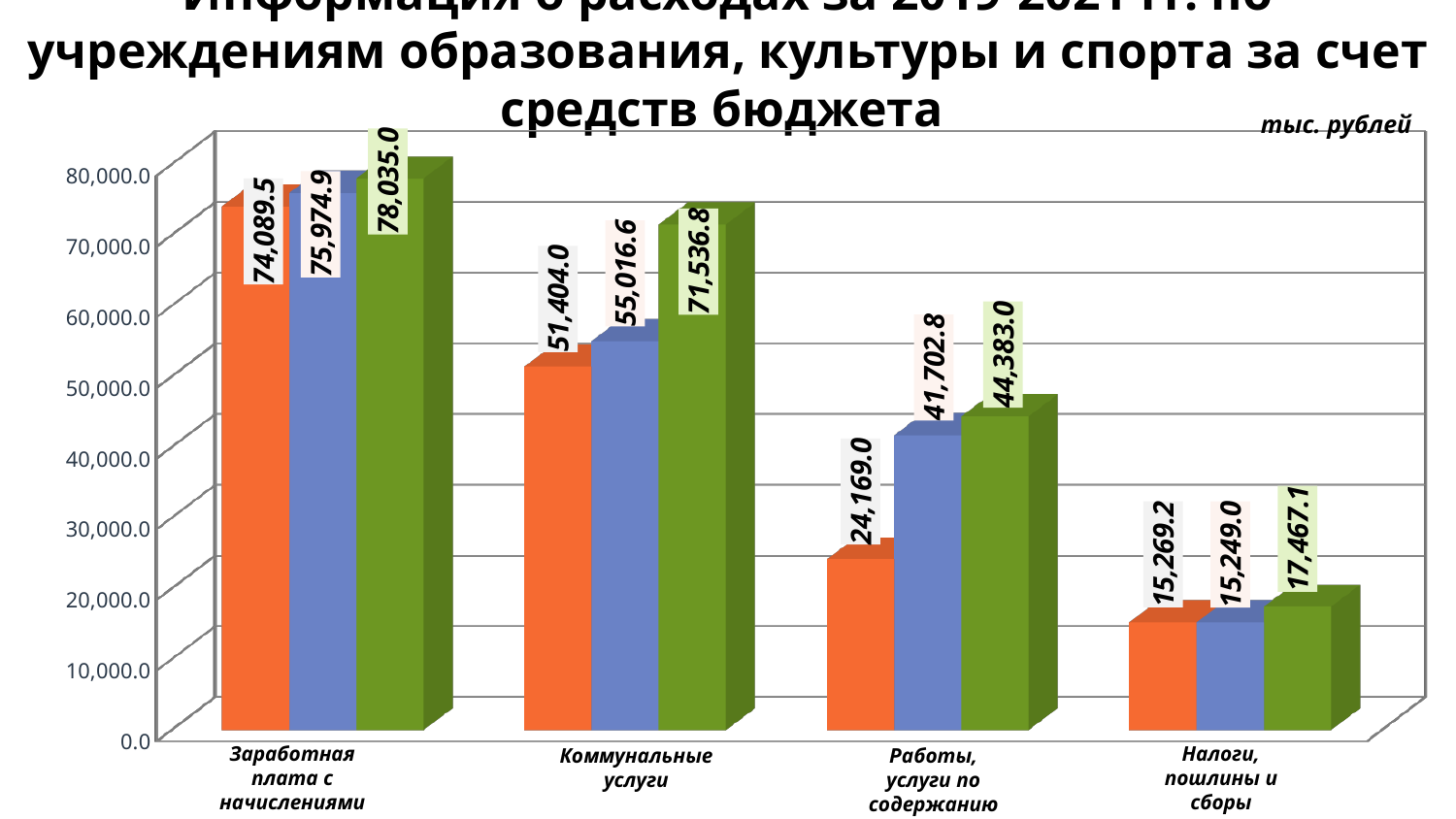
Which category has the highest green bar? Заработная плата с начислениями What is the difference between the blue bar and the orange bar for «Работы, услуги по содержанию»? 17,533.8 In what units are the values on the chart given, according to the note at the top right? тыс. рублей For «Налоги, пошлины и сборы», which is larger: the orange bar or the blue bar? the orange bar How many categories are shown on the x axis? 4 What is the difference between the green bar and the orange bar for «Коммунальные услуги»? 20,132.8 What is the value of the green bar for «Заработная плата с начислениями»? 78,035.0 What kind of chart is shown on the slide? bar chart Which category has the lowest orange bar? Налоги, пошлины и сборы What is the value of the green bar for «Налоги, пошлины и сборы»? 17,467.1 What is the value of the blue bar for «Работы, услуги по содержанию»? 41,702.8 What is the value of the orange bar for «Коммунальные услуги»? 51,404.0